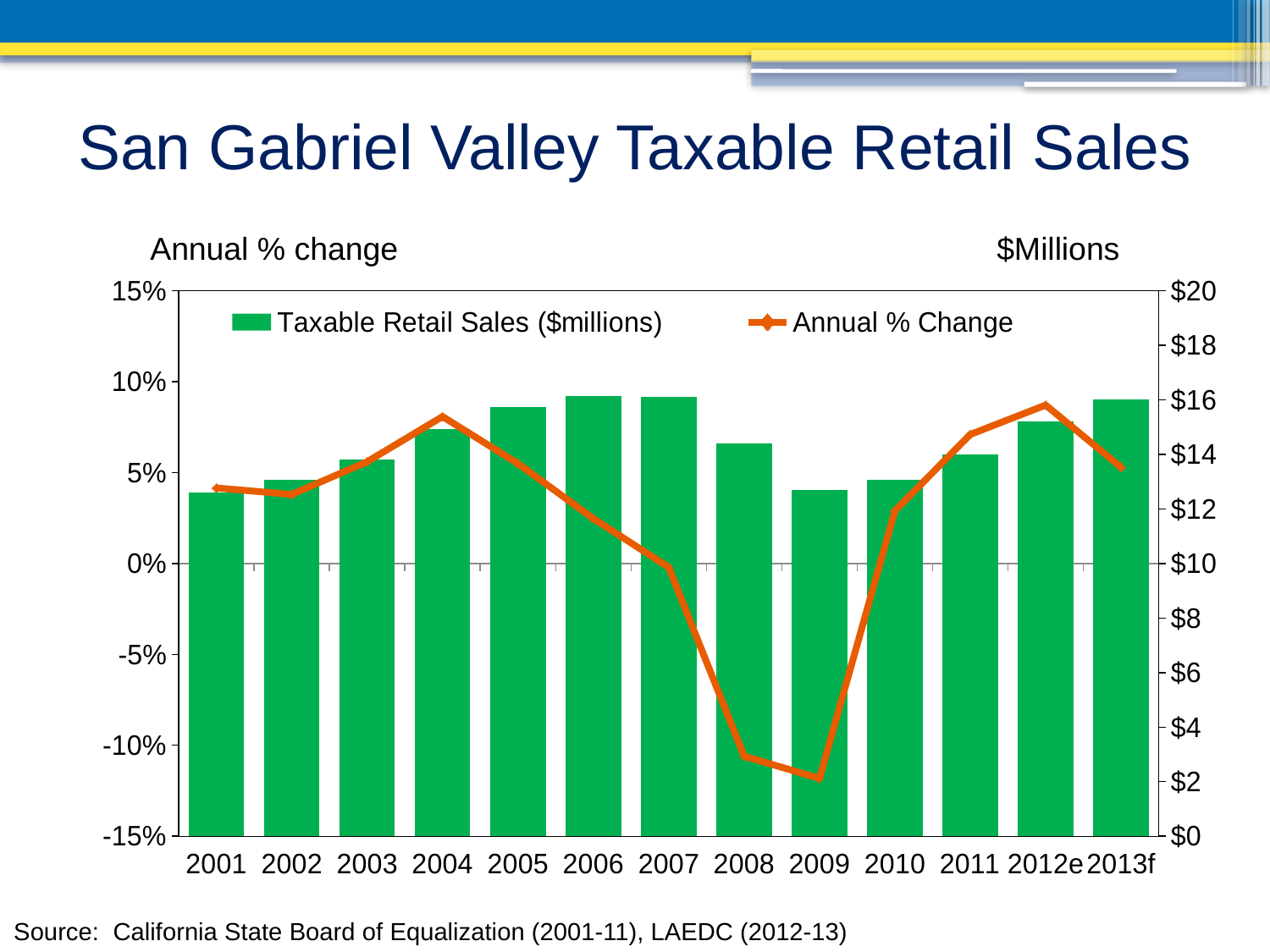
What kind of chart is shown on the slide? A combined bar and line chart Is the Annual % Change for 2009 greater or less than -10%? less Is the Taxable Retail Sales value for 2004 greater or less than $14 million? greater Which year has the lowest Annual % Change? 2009 How many series does the legend list? 2 Is the Annual % Change for 2011 greater or less than 5%? greater Which is larger, the Taxable Retail Sales bar for 2011 or for 2012e? 2012e Which series is plotted as green bars? Taxable Retail Sales ($millions) Does the Annual % Change line rise or fall from 2007 to 2009? Fall How many years are shown on the x axis? 13 Which is larger, the Taxable Retail Sales bar for 2003 or for 2004? 2004